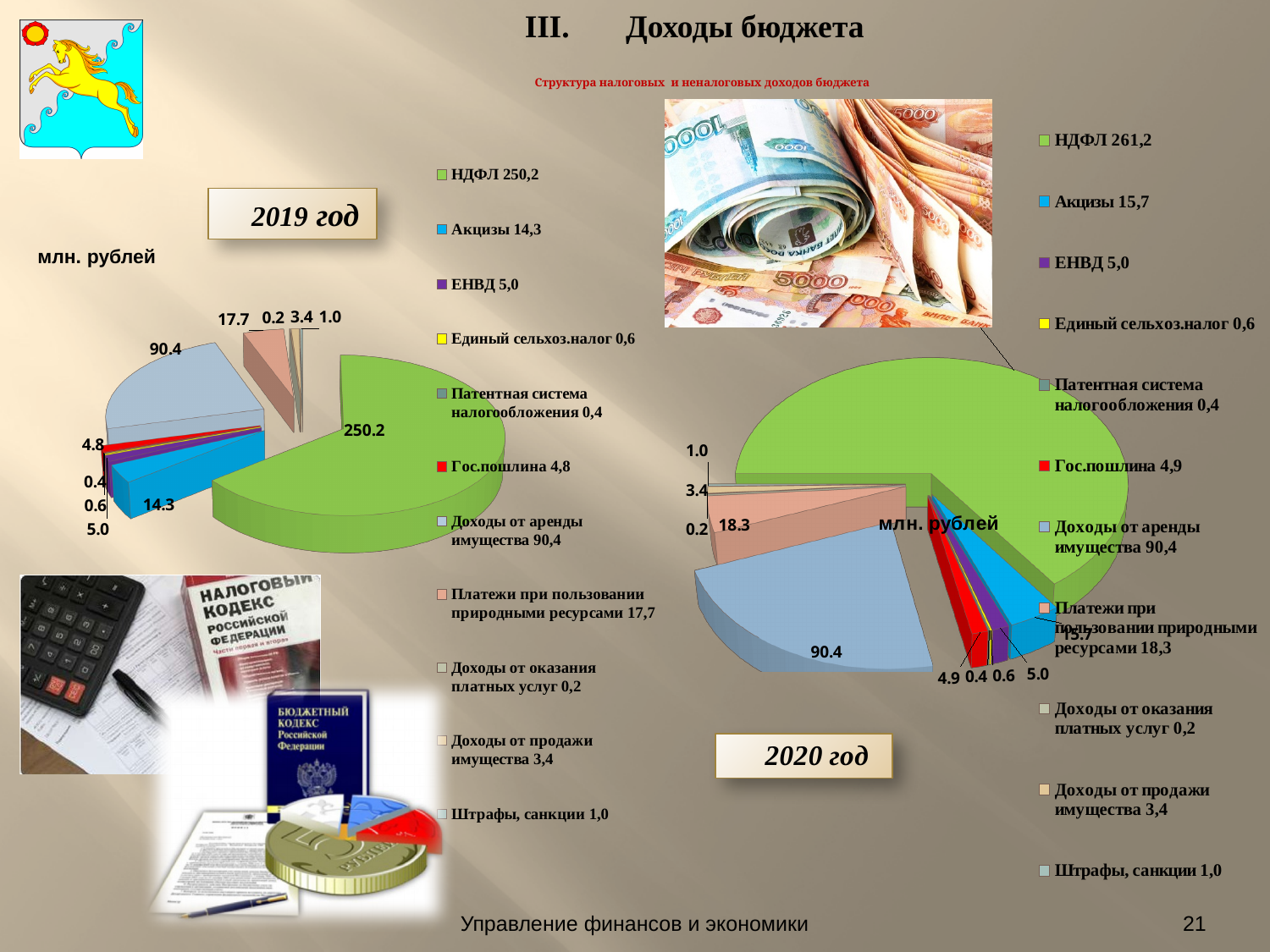
In the 2019 год chart, which category has the smallest value? Доходы от оказания платных услуг In the 2020 год chart, what is the value for НДФЛ? 261.2 In the 2019 год chart, what is the value for Акцизы? 14.3 In the 2020 год chart, which category has the largest value? НДФЛ In the 2020 год chart, which is larger: Акцизы or ЕНВД? Акцизы What unit is stated for the values in both charts? млн. рублей In the 2019 год chart, what is the difference between НДФЛ and Доходы от аренды имущества? 159.8 How many categories does the legend of the 2020 год chart list? 11 In the 2020 год chart, what is the value for Платежи при пользовании природными ресурсами? 18.3 By how much did НДФЛ increase from the 2019 год chart to the 2020 год chart? 11.0 In the 2019 год chart, what is the value for НДФЛ? 250.2 What kind of chart is used for the 2019 год data? Pie chart